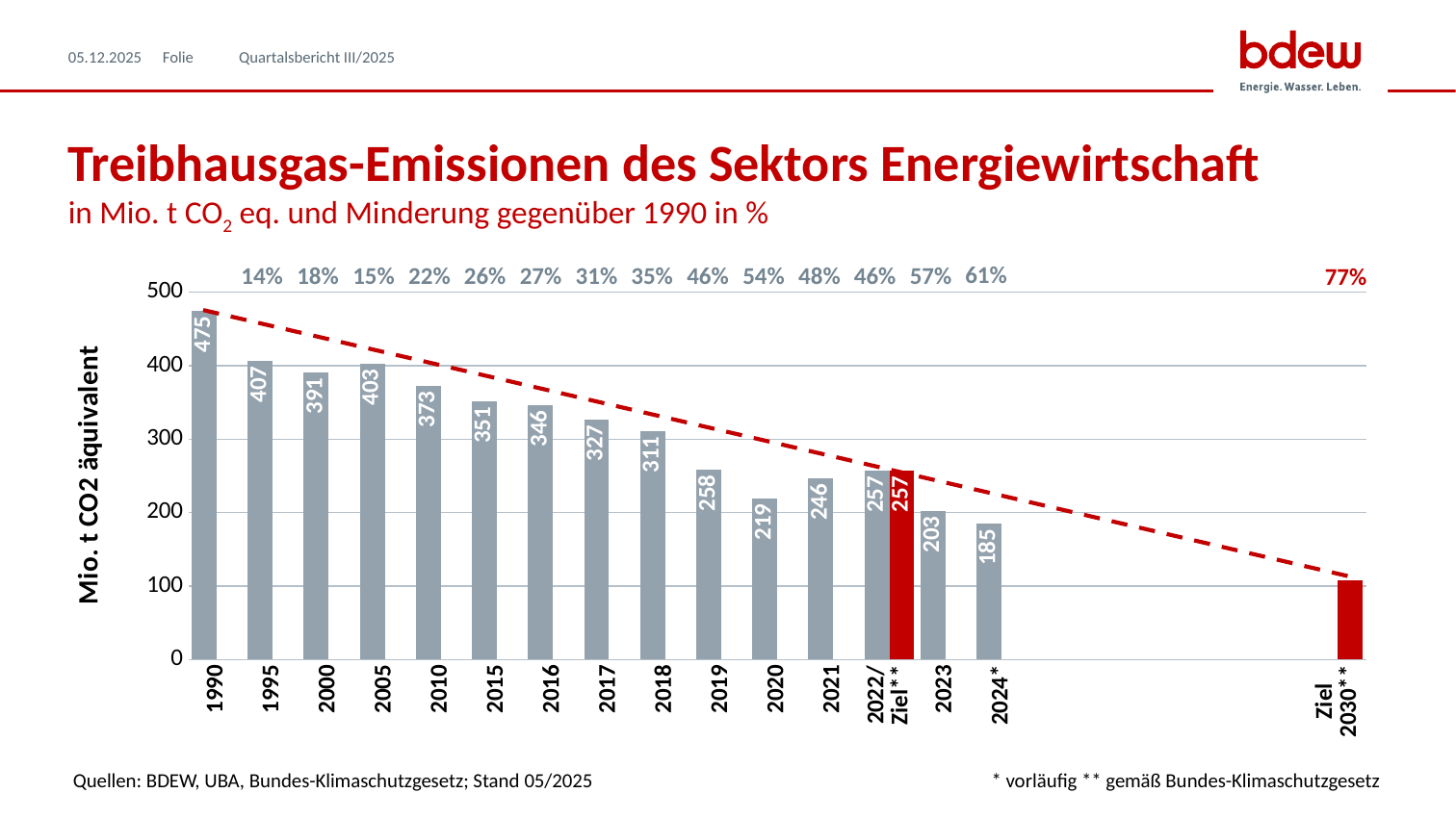
Which is larger, the value for 2020 or the value for 2021? 2021 Which year has the highest emissions? 1990 What is the value for 2005? 403 What is the value for 2024*? 185 Is the value for Ziel 2030** greater or less than 200? less How many categories are labelled on the x axis? 16 What reduction percentage compared to 1990 is shown for Ziel 2030**? 77% Do the emissions generally rise or fall from 1990 to 2024*? fall What kind of chart is this? bar chart What is the value for 1990? 475 What is the difference between the values for 1990 and 2024*? 290 Among the years 1990 to 2024*, which has the lowest emissions? 2024*